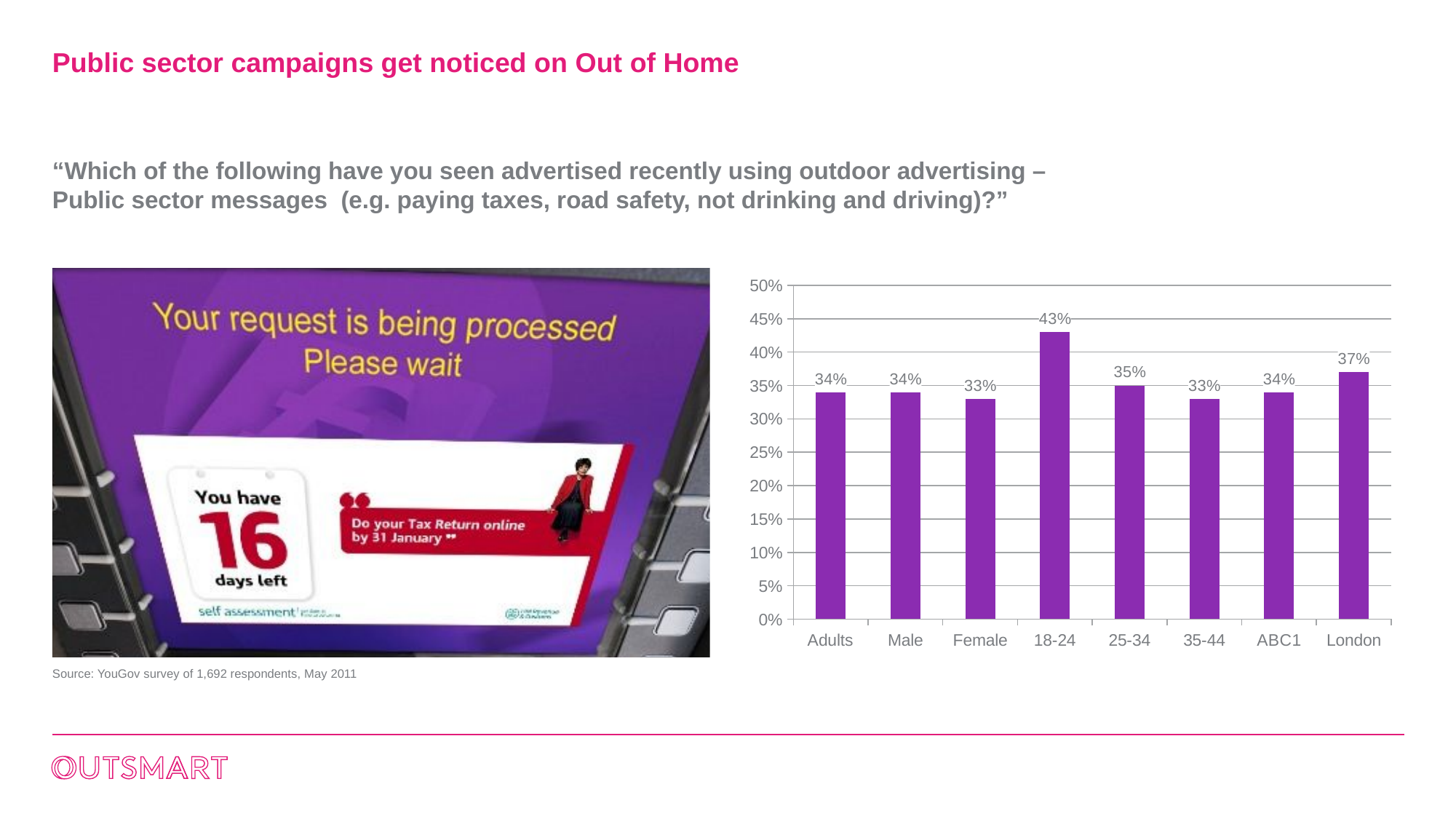
What is the highest value shown on the y axis? 50% Is the value for 18-24 greater or less than 40%? greater What is the value for Adults? 34% What is the value for 25-34? 35% What is the difference between the values for 18-24 and Female? 10% Which category has the highest value? 18-24 What is the value for 18-24? 43% What is the difference between the values for London and ABC1? 3% How many categories are shown on the x axis? 8 Which is larger, the value for London or the value for 35-44? London What kind of chart is shown on the slide? Bar chart What is the value for London? 37%